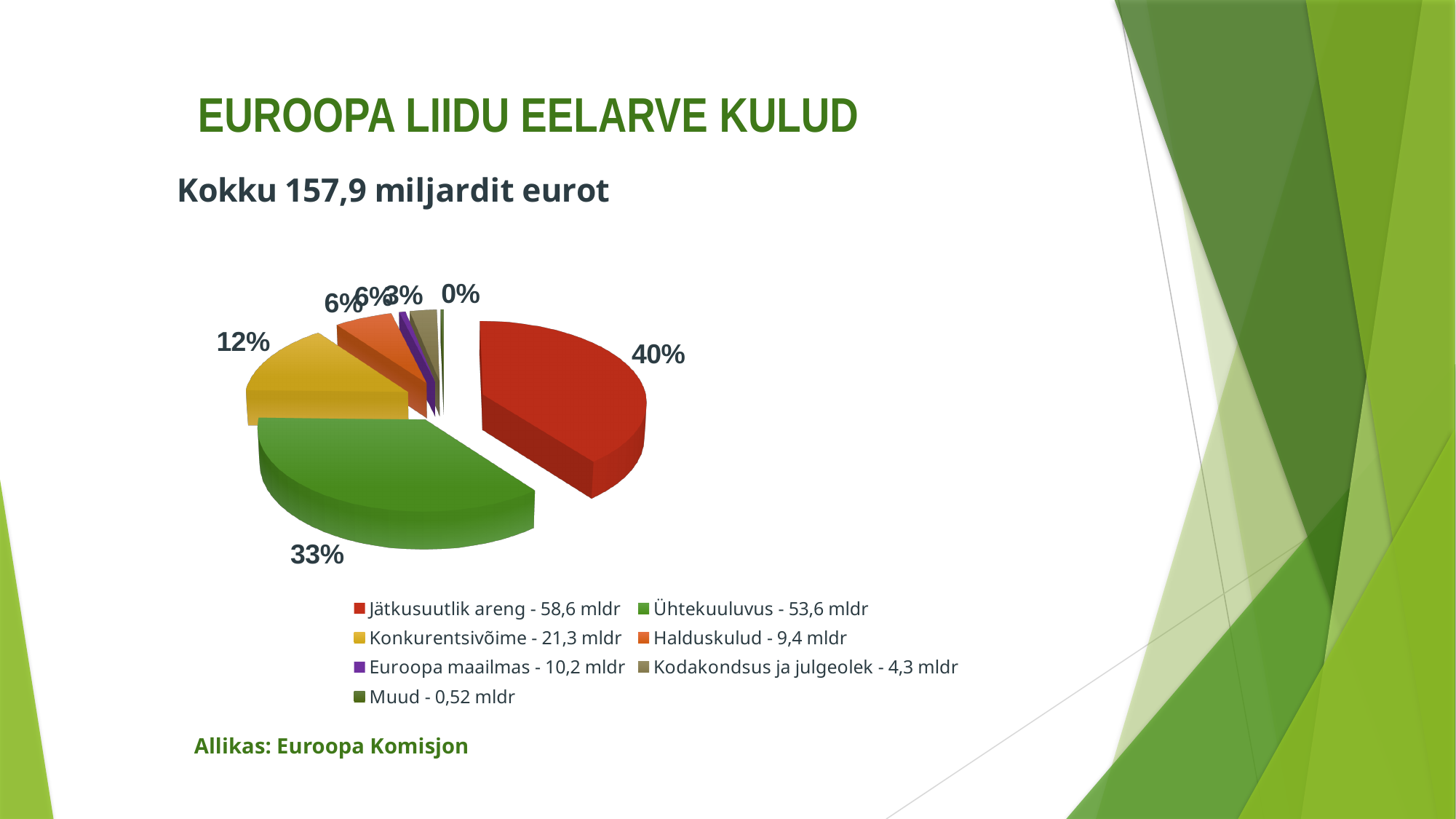
How many categories does the pie chart have? 7 What percentage of the pie does Konkurentsivõime represent? 12% What total amount is stated above the chart? 157,9 miljardit eurot Which category has the largest slice of the pie? Jätkusuutlik areng What percentage label is shown for Muud? 0% According to the legend, what amount is given for Halduskulud? 9,4 mldr What percentage of the pie does Ühtekuuluvus represent? 33% What kind of chart is shown on the slide? pie chart According to the legend, how much larger is Jätkusuutlik areng than Ühtekuuluvus? 5,0 mldr Which is larger, the slice for Konkurentsivõime or the slice for Halduskulud? Konkurentsivõime Which category has the smallest slice of the pie? Muud